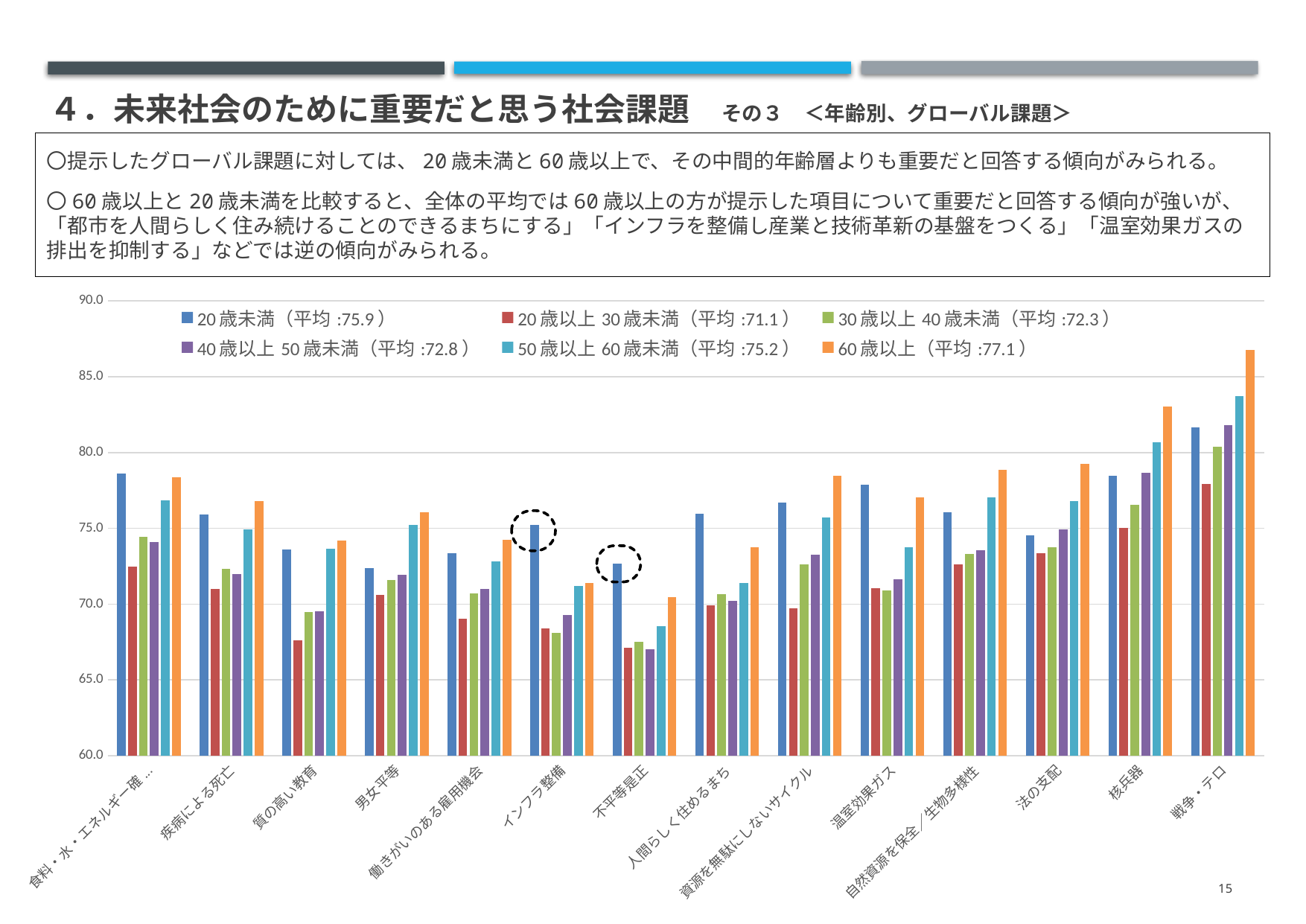
According to the legend, which series has the lowest average (平均)? 20歳以上30歳未満 How many series does the legend list? 6 For 人間らしく住めるまち, which is larger: the 20歳未満 value or the 60歳以上 value? 20歳未満 For 核兵器, which is larger: the 20歳未満 value or the 60歳以上 value? 60歳以上 Which category has the highest value for the 60歳以上 series? 戦争・テロ What kind of chart is shown on the slide? bar chart According to the legend, what is the average (平均) for the 60歳以上 series? 77.1 Which category has the lowest value for the 50歳以上60歳未満 series? 不平等是正 Is the value for 20歳未満 in 戦争・テロ greater or less than 80.0? greater How many categories are shown along the x axis? 14 Is the value for 20歳以上30歳未満 in 質の高い教育 greater or less than 70.0? less Is the value for 60歳以上 in 核兵器 greater or less than 80.0? greater